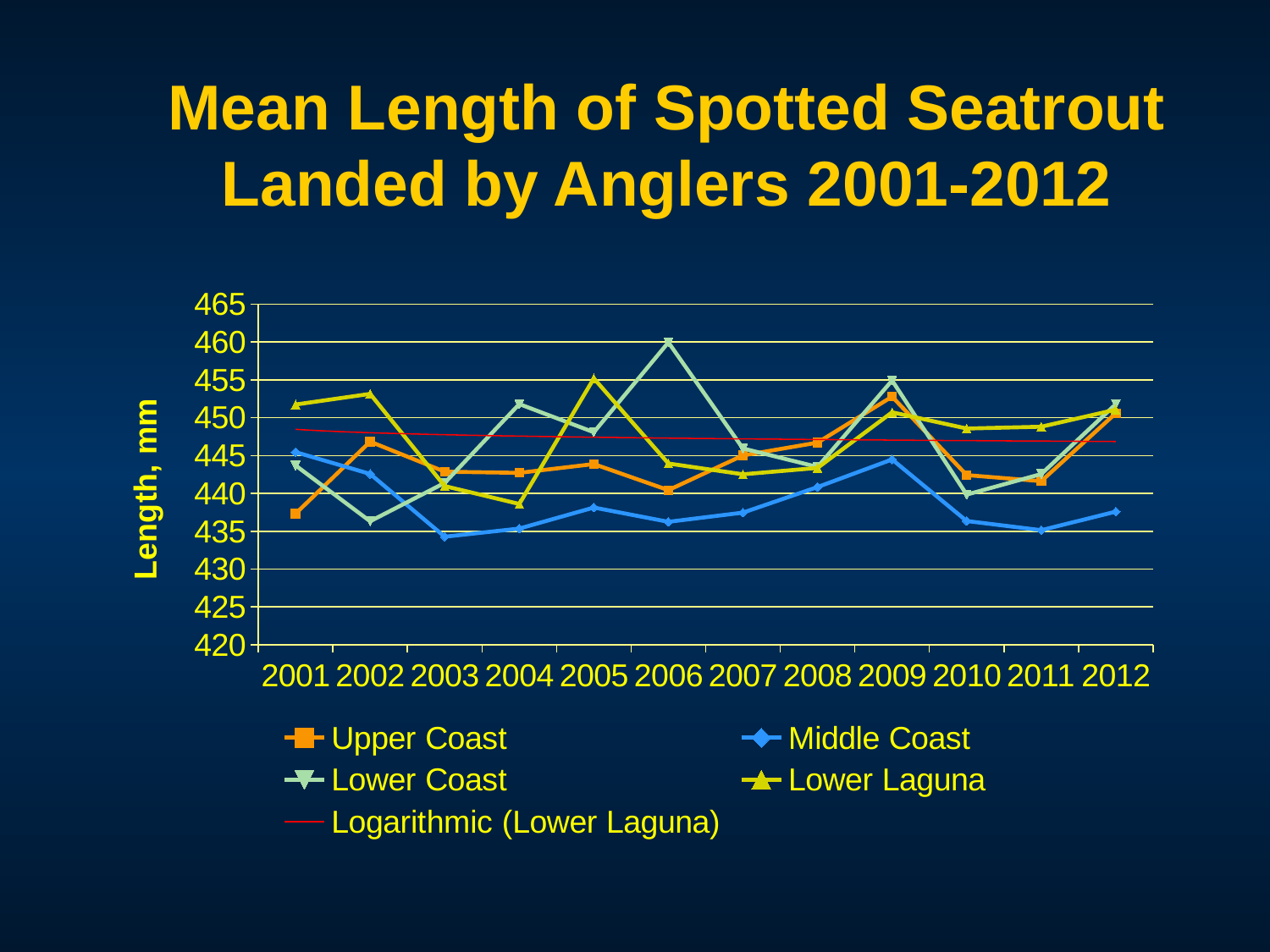
How many years are plotted along the x axis? 12 Is the value for Middle Coast in 2003 greater or less than 440? less In 2006, which is larger: Lower Coast or Middle Coast? Lower Coast In which year does the Lower Coast series reach its highest value? 2006 Is the value for Upper Coast in 2001 greater or less than 440? less What type of chart is shown on the slide? line chart How many entries does the legend list? 5 Which series has the highest value in 2001? Lower Laguna What is the label of the y axis? Length, mm In which year does the Upper Coast series have its lowest value? 2001 Is the value for Lower Laguna in 2005 greater or less than 450? greater